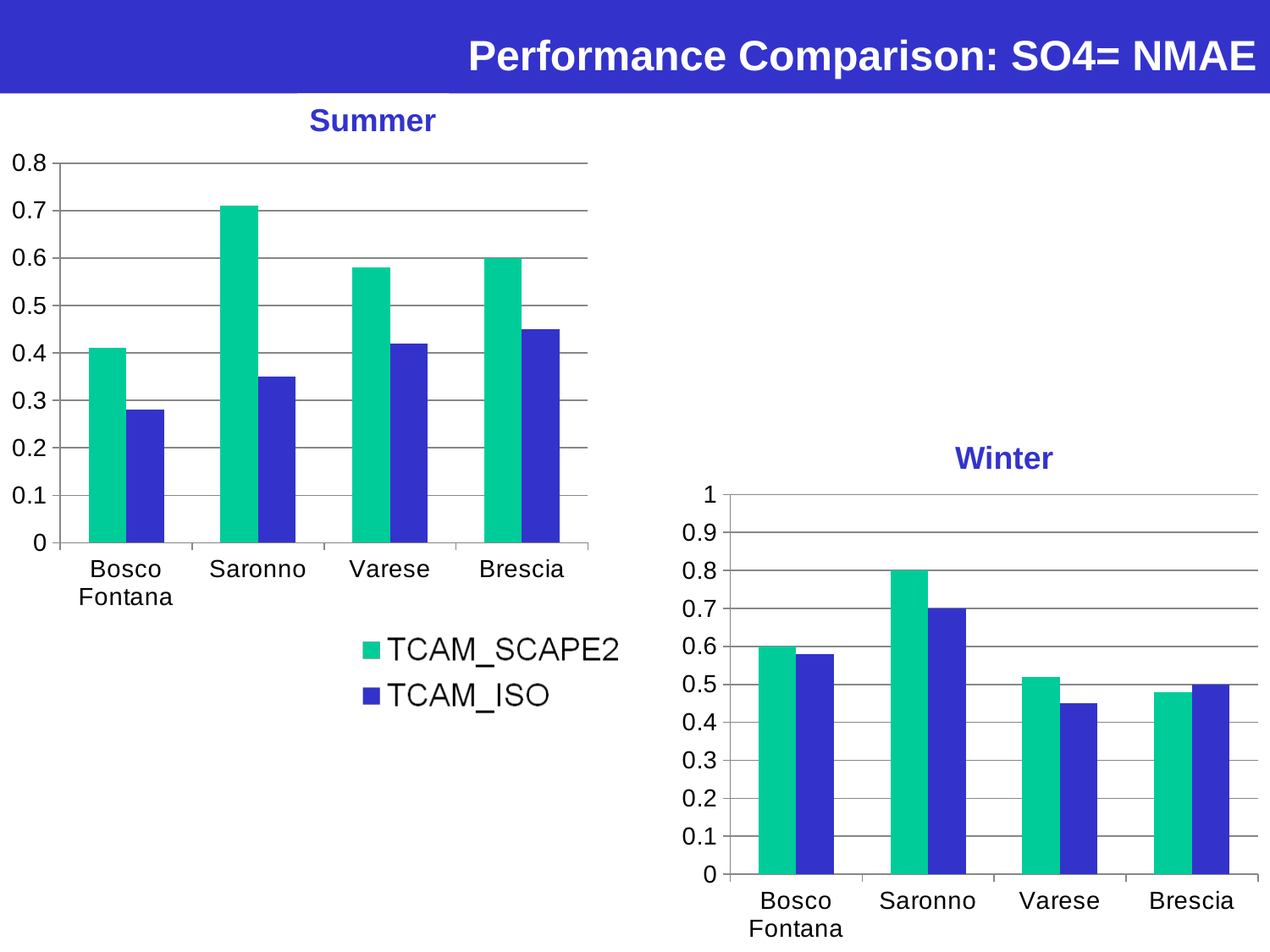
How many series does the legend list? 2 On the Summer chart, what is the TCAM_SCAPE2 value for Brescia? 0.6 On the Summer chart, which is larger for Saronno, TCAM_SCAPE2 or TCAM_ISO? TCAM_SCAPE2 On the Winter chart, what is the TCAM_ISO value for Brescia? 0.5 On the Winter chart, what is the TCAM_ISO value for Saronno? 0.7 On the Summer chart, which station has the lowest TCAM_ISO value? Bosco Fontana On the Summer chart, is the TCAM_ISO value for Bosco Fontana greater or less than 0.4? less On the Summer chart, is the TCAM_SCAPE2 value for Varese greater or less than 0.5? greater On the Winter chart, what is the TCAM_SCAPE2 value for Saronno? 0.8 On the Summer chart, which station has the highest TCAM_SCAPE2 value? Saronno On the Winter chart, which station has the highest TCAM_ISO value? Saronno On the Winter chart, what is the difference between the TCAM_SCAPE2 and TCAM_ISO values for Saronno? 0.1